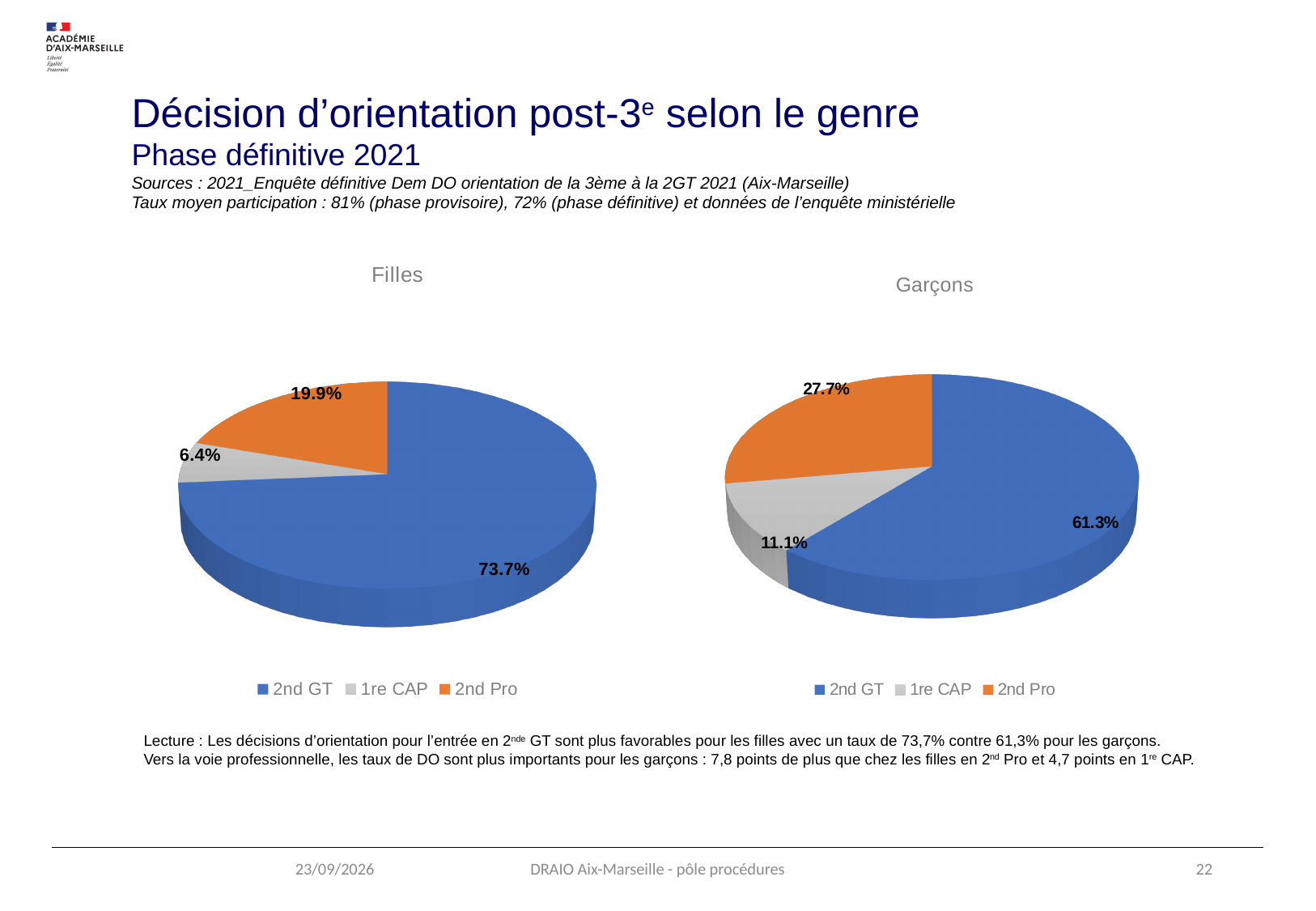
In the 'Garçons' pie chart, what share is labelled for 1re CAP? 11.1% What type of chart is used for 'Garçons'? Pie chart In the 'Garçons' pie chart, which category has the largest slice? 2nd GT In the 'Filles' pie chart, what share is labelled for 1re CAP? 6.4% In the 'Filles' pie chart, what share is labelled for 2nd GT? 73.7% In the 'Garçons' pie chart, what colour is the 2nd Pro slice? Orange How many categories does the 'Filles' pie chart show? 3 Which is larger: the 2nd Pro share in the 'Filles' chart or the 2nd Pro share in the 'Garçons' chart? Garçons What are the legend entries listed under the 'Filles' pie chart? 2nd GT, 1re CAP, 2nd Pro In the 'Garçons' pie chart, what share is labelled for 2nd Pro? 27.7% In the 'Filles' pie chart, which category has the smallest slice? 1re CAP What is the difference between the 2nd GT share in the 'Filles' chart and the 2nd GT share in the 'Garçons' chart? 12.4 percentage points